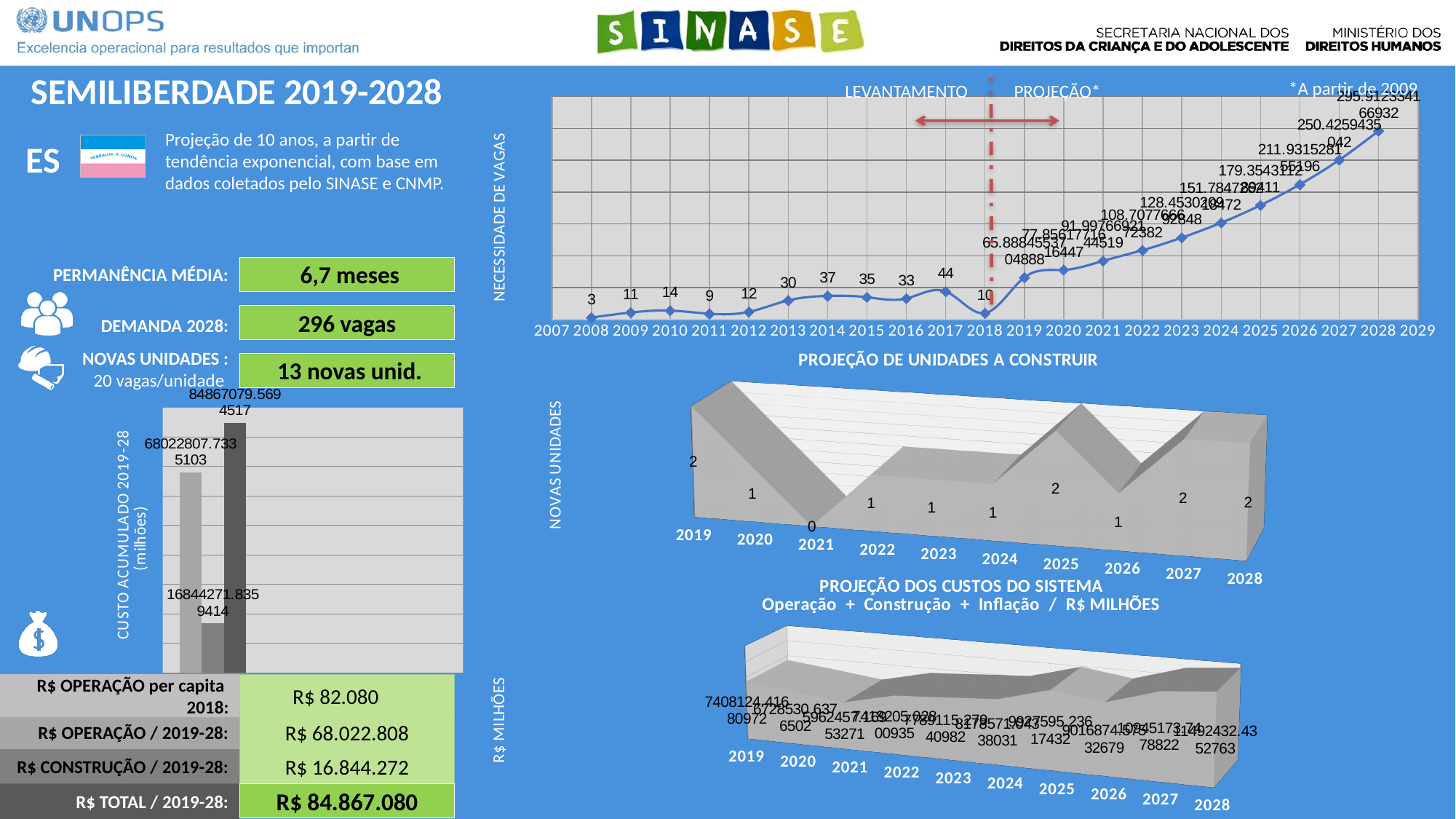
In the chart titled PROJEÇÃO DE UNIDADES A CONSTRUIR, how many years are shown on the x axis? 10 In the top line chart (NECESSIDADE DE VAGAS), which year has the lowest value? 2008 What kind of chart is the CUSTO ACUMULADO 2019-28 chart on the left of the slide? bar chart In the top line chart (NECESSIDADE DE VAGAS), what is the value for 2008? 3 How many bars does the CUSTO ACUMULADO 2019-28 chart on the left of the slide have? 3 In the chart titled PROJEÇÃO DE UNIDADES A CONSTRUIR, what is the value for 2021? 0 In the top line chart (NECESSIDADE DE VAGAS), which year has the larger value, 2013 or 2014? 2014 In the top line chart (NECESSIDADE DE VAGAS), do the values rise or fall from 2019 to 2028? rise In the top line chart (NECESSIDADE DE VAGAS), which year has the highest value? 2028 In the top line chart (NECESSIDADE DE VAGAS), what is the difference between the values for 2017 and 2018? 34 In the top line chart (NECESSIDADE DE VAGAS), what is the value for 2018? 10 In the top line chart (NECESSIDADE DE VAGAS), what is the value for 2017? 44